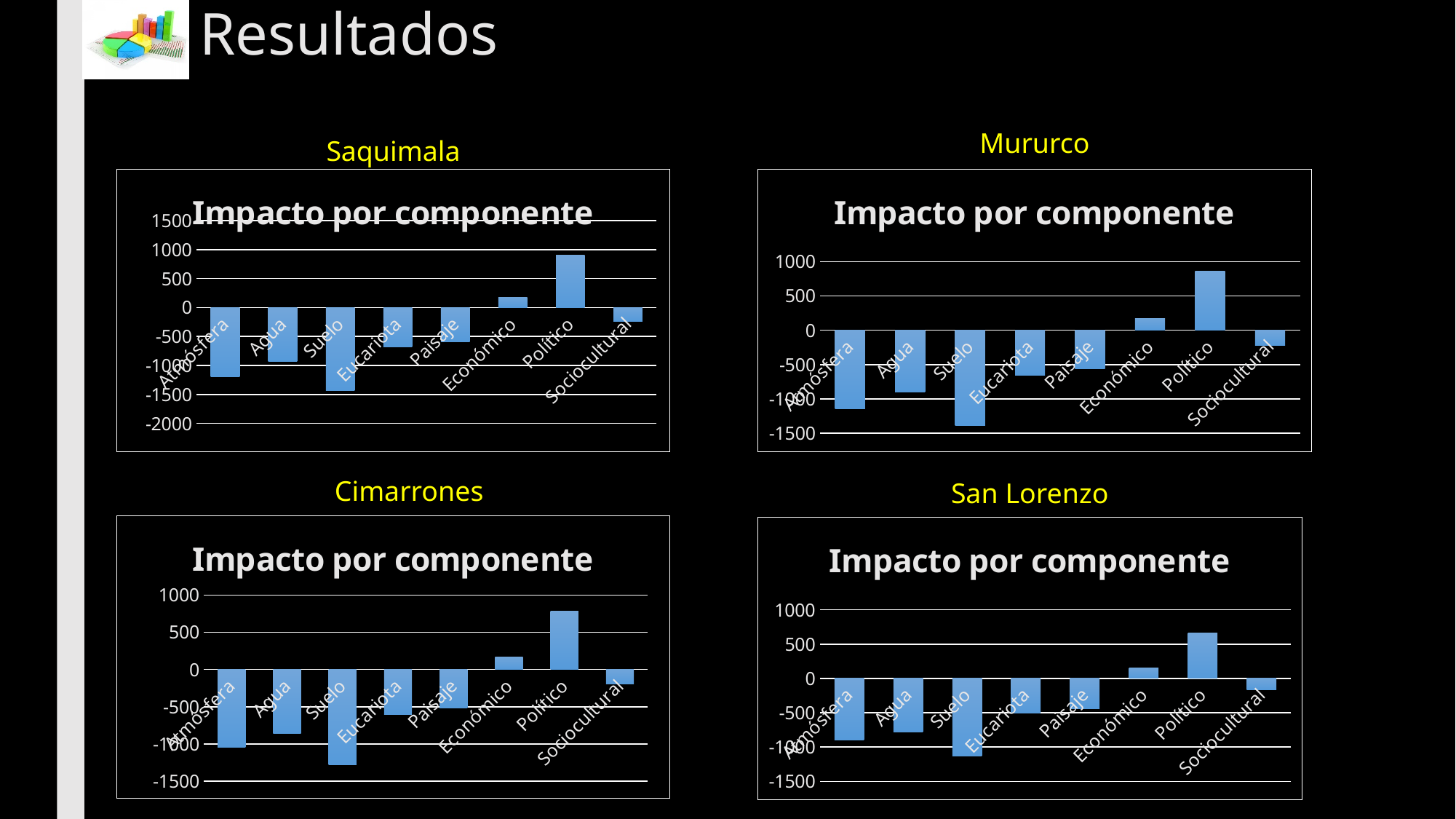
In the Mururco chart, which category has the lowest value? Suelo In the Saquimala chart, which category has the highest value? Político In the Mururco chart, is the value for Suelo greater or less than -1000? less In the Saquimala chart, is the value for Político greater or less than 500? greater How many categories are shown on the x axis of the Mururco chart? 8 What is the title shown inside the Cimarrones chart? Impacto por componente In the Cimarrones chart, which category has the highest value? Político In the San Lorenzo chart, which category has the lowest value? Suelo What kind of chart is the Saquimala chart? bar chart In the San Lorenzo chart, is the value for Económico greater or less than 500? less In the Saquimala chart, which is larger, the value for Atmósfera or the value for Agua? Agua